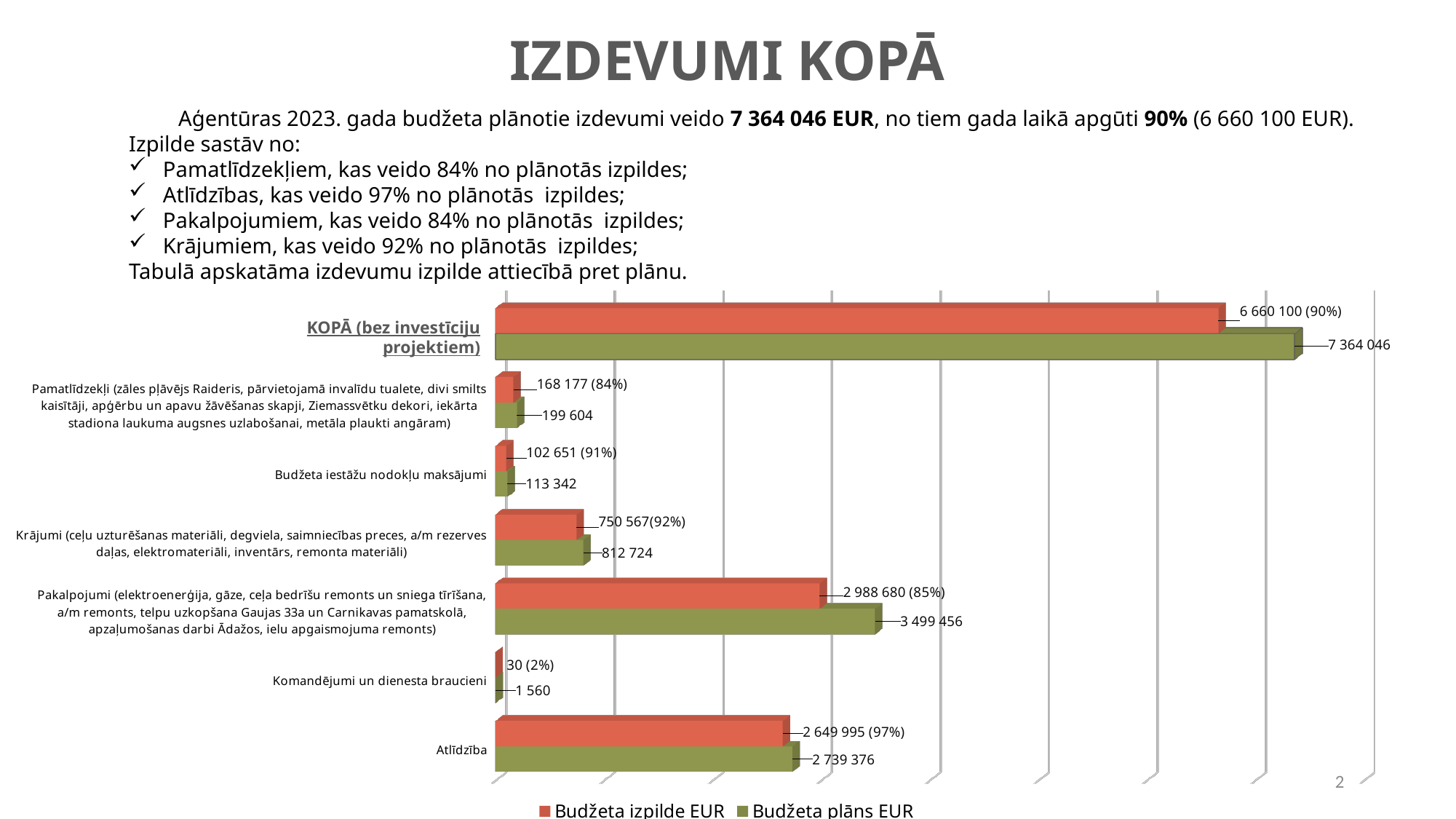
What data label is shown for the Budžeta izpilde EUR bar of Budžeta iestāžu nodokļu maksājumi? 102 651 (91%) What kind of chart is shown on the slide? Bar chart How many categories are shown on the chart? 7 Which is larger: the Budžeta plāns EUR value for Atlīdzība or for Krājumi? Atlīdzība How many series does the legend list? 2 What is the difference between the Budžeta plāns EUR and Budžeta izpilde EUR values for Pakalpojumi? 510 776 What data label is shown for the Budžeta izpilde EUR bar of Atlīdzība? 2 649 995 (97%) What is the difference between the Budžeta plāns EUR and Budžeta izpilde EUR values for KOPĀ (bez investīciju projektiem)? 703 946 Excluding the KOPĀ total row, which category has the highest Budžeta plāns EUR value? Pakalpojumi What is the Budžeta plāns EUR value for KOPĀ (bez investīciju projektiem)? 7 364 046 Which category has the lowest Budžeta izpilde EUR value? Komandējumi un dienesta braucieni What is the Budžeta plāns EUR value for Komandējumi un dienesta braucieni? 1 560